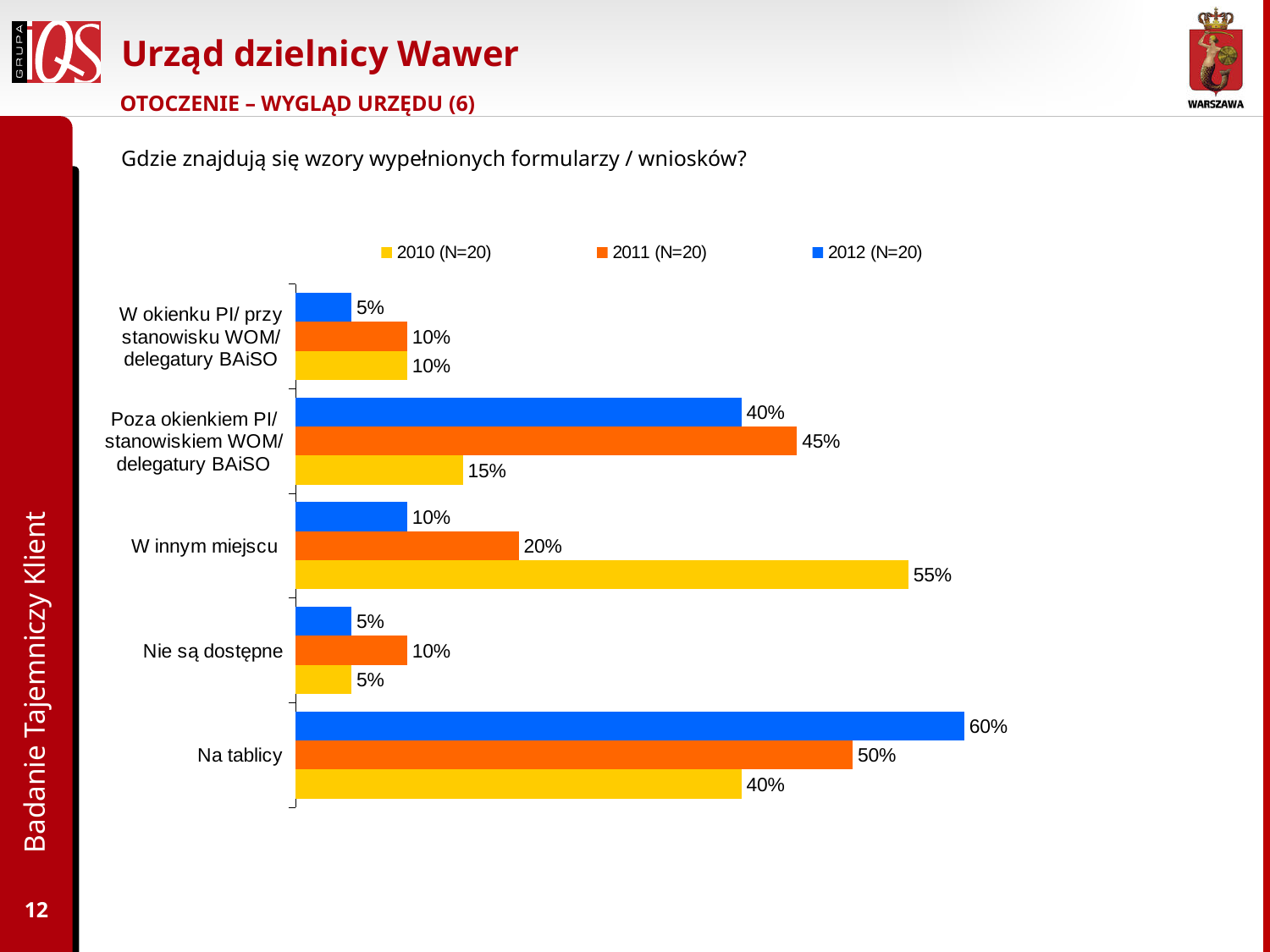
How many series does the legend list? 3 What is the value for 'W innym miejscu' in the 2010 (N=20) series? 55% How many categories are shown on the chart? 5 What is the value for 'Poza okienkiem PI/ stanowiskiem WOM/ delegatury BAiSO' in the 2011 (N=20) series? 45% What colour are the bars for the 2012 (N=20) series? blue What is the difference between the 2011 (N=20) and 2010 (N=20) values for 'Poza okienkiem PI/ stanowiskiem WOM/ delegatury BAiSO'? 30% What is the value for 'Na tablicy' in the 2012 (N=20) series? 60% For 'W innym miejscu', which series has the larger value: 2010 (N=20) or 2011 (N=20)? 2010 (N=20) What kind of chart is shown on the slide? bar chart What is the difference between the 2012 (N=20) and 2010 (N=20) values for 'Na tablicy'? 20% Which category has the highest value in the 2012 (N=20) series? Na tablicy